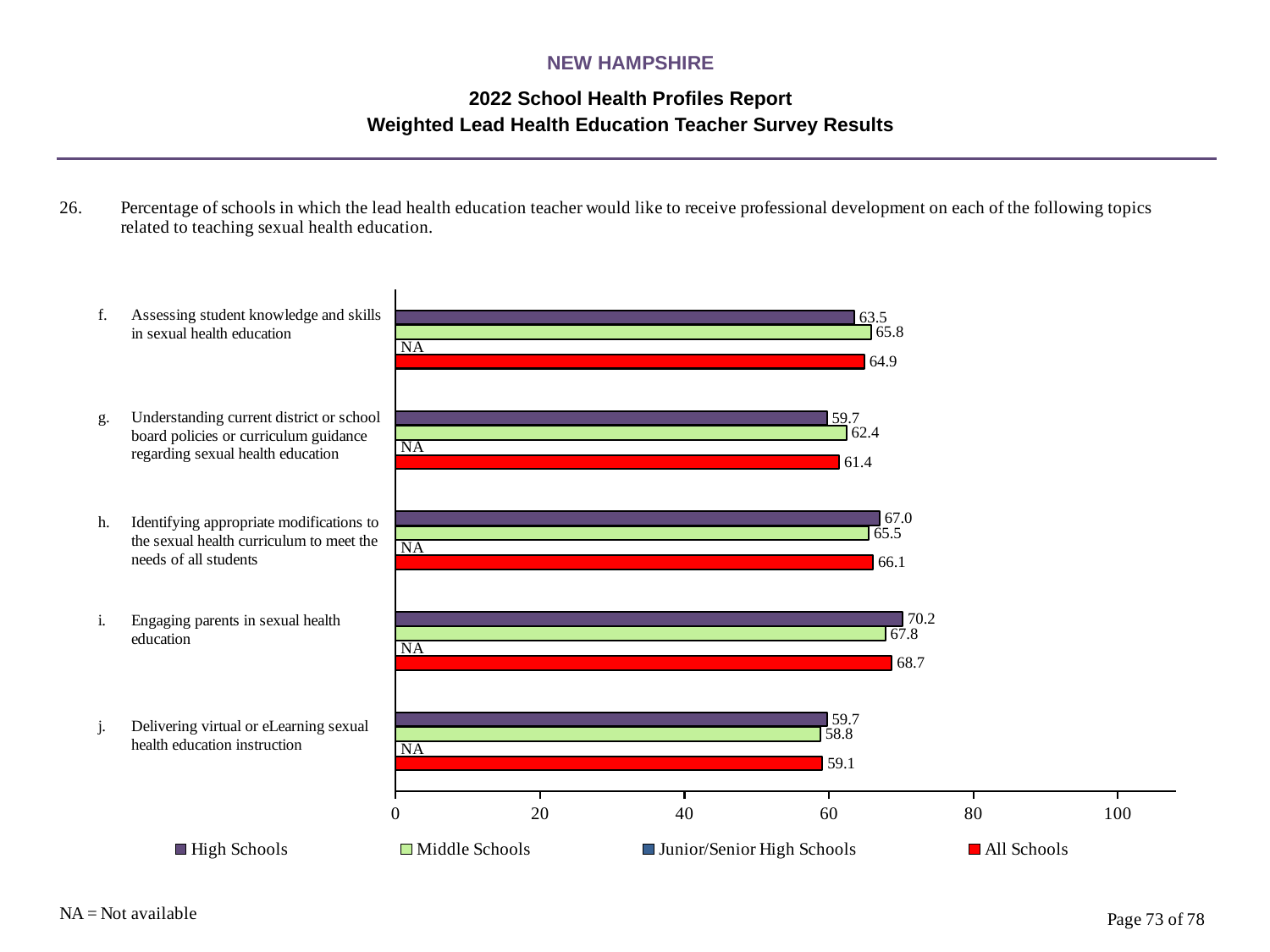
What is the difference between the High Schools and Middle Schools values for 'Engaging parents in sexual health education'? 2.4 What is the value for All Schools for 'Delivering virtual or eLearning sexual health education instruction'? 59.1 For 'Identifying appropriate modifications to the sexual health curriculum to meet the needs of all students', which is larger: the High Schools value or the Middle Schools value? High Schools Is the All Schools value for 'Engaging parents in sexual health education' greater or less than 60? greater What kind of chart is shown on the slide? bar chart What is shown for Junior/Senior High Schools for 'Understanding current district or school board policies or curriculum guidance regarding sexual health education'? NA What is the value for High Schools for 'Engaging parents in sexual health education'? 70.2 How many topics are listed on the chart? 5 What is the value for Middle Schools for 'Assessing student knowledge and skills in sexual health education'? 65.8 How many series does the legend list? 4 Which topic has the highest value for High Schools? Engaging parents in sexual health education Which topic has the lowest value for Middle Schools? Delivering virtual or eLearning sexual health education instruction